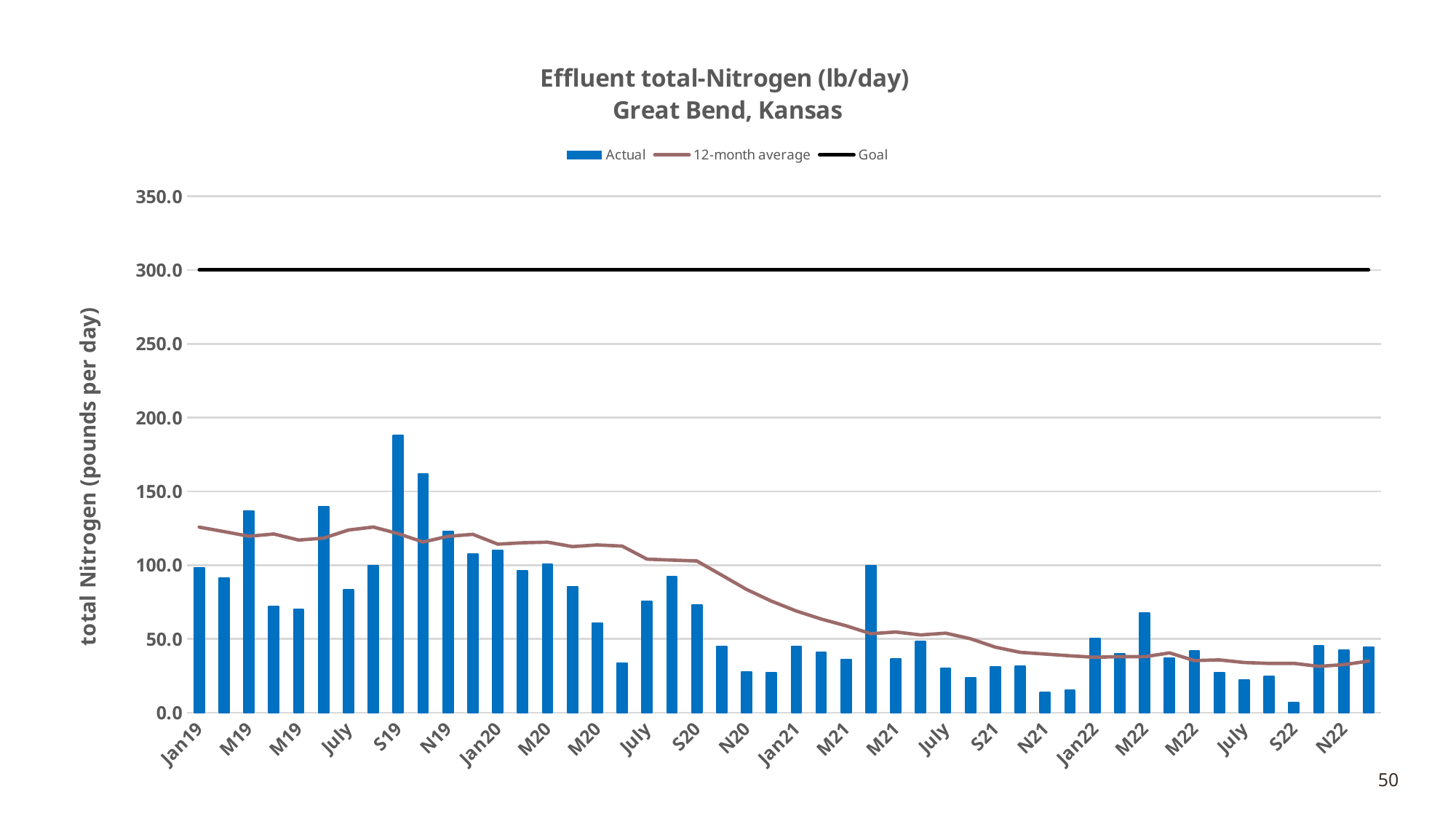
What kind of chart is used to show the Actual series? bar chart What is the y-axis title of the chart? total Nitrogen (pounds per day) Is the Actual value for N20 greater or less than 50? less Is the Actual value for S22 greater or less than 50? less What value does the Goal line sit at? 300.0 Which is larger, the Actual value for S19 or for N19? S19 Which month has the highest Actual bar? S19 Which month has the lowest Actual bar? S22 Is the Actual value for S19 greater or less than 150? greater Which is larger, the Actual value for Jan22 or for N21? Jan22 How many series does the legend list? 3 Does the 12-month average line generally rise or fall from Jan19 to N22? fall